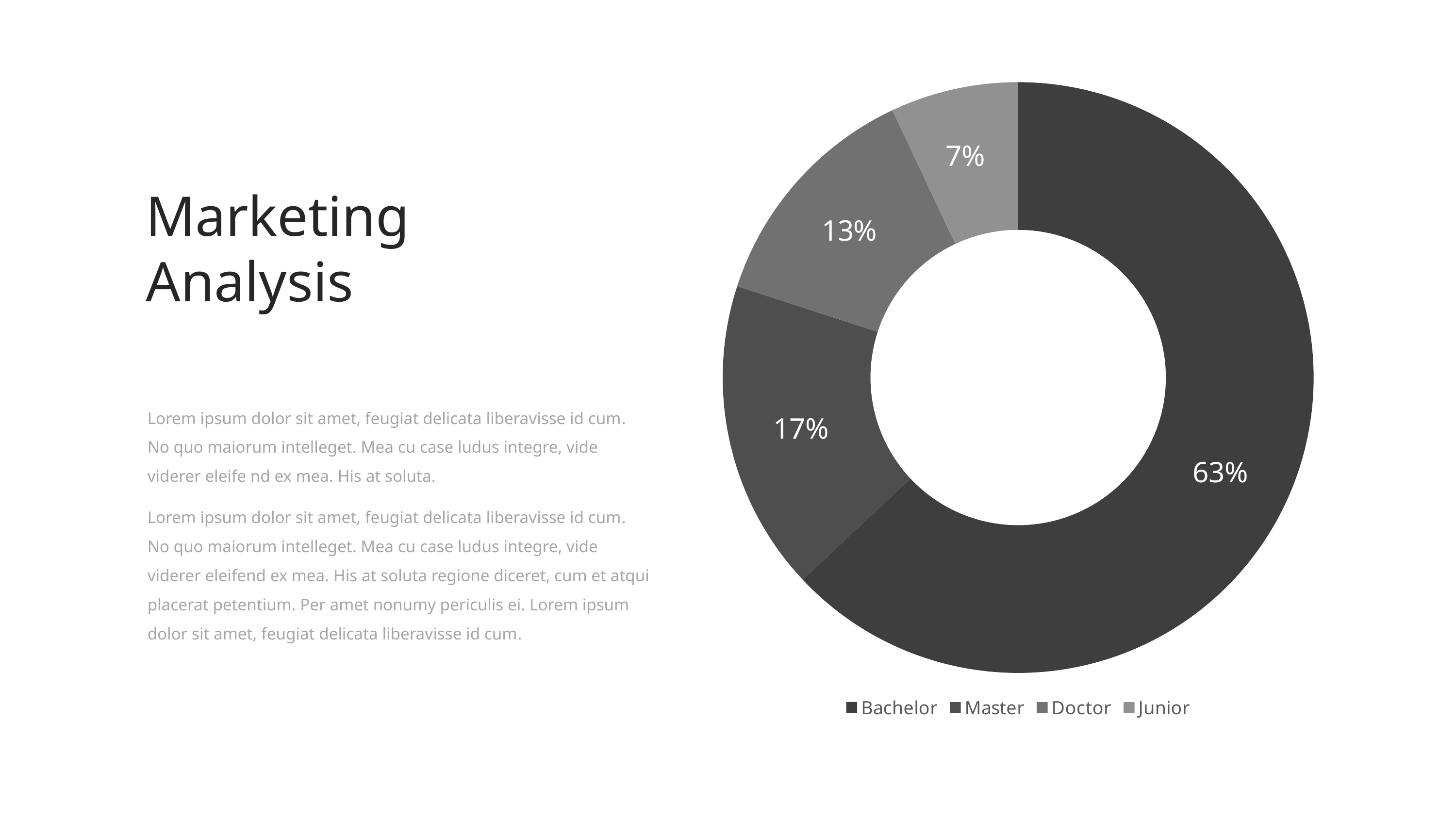
What type of chart is shown on the slide? Doughnut chart How many categories are shown in the doughnut chart? 4 What is the difference in percentage points between the Doctor and Junior shares? 6 What percentage of the doughnut chart does Master account for? 17% What percentage of the doughnut chart does Junior account for? 7% Which category has the smallest share of the doughnut chart? Junior What is the difference in percentage points between the Bachelor and Master shares? 46 What percentage of the doughnut chart does Doctor account for? 13% What percentage of the doughnut chart does Bachelor account for? 63% Which has a larger share, Master or Doctor? Master Which category has the largest share of the doughnut chart? Bachelor What is the title of the slide containing the chart? Marketing Analysis